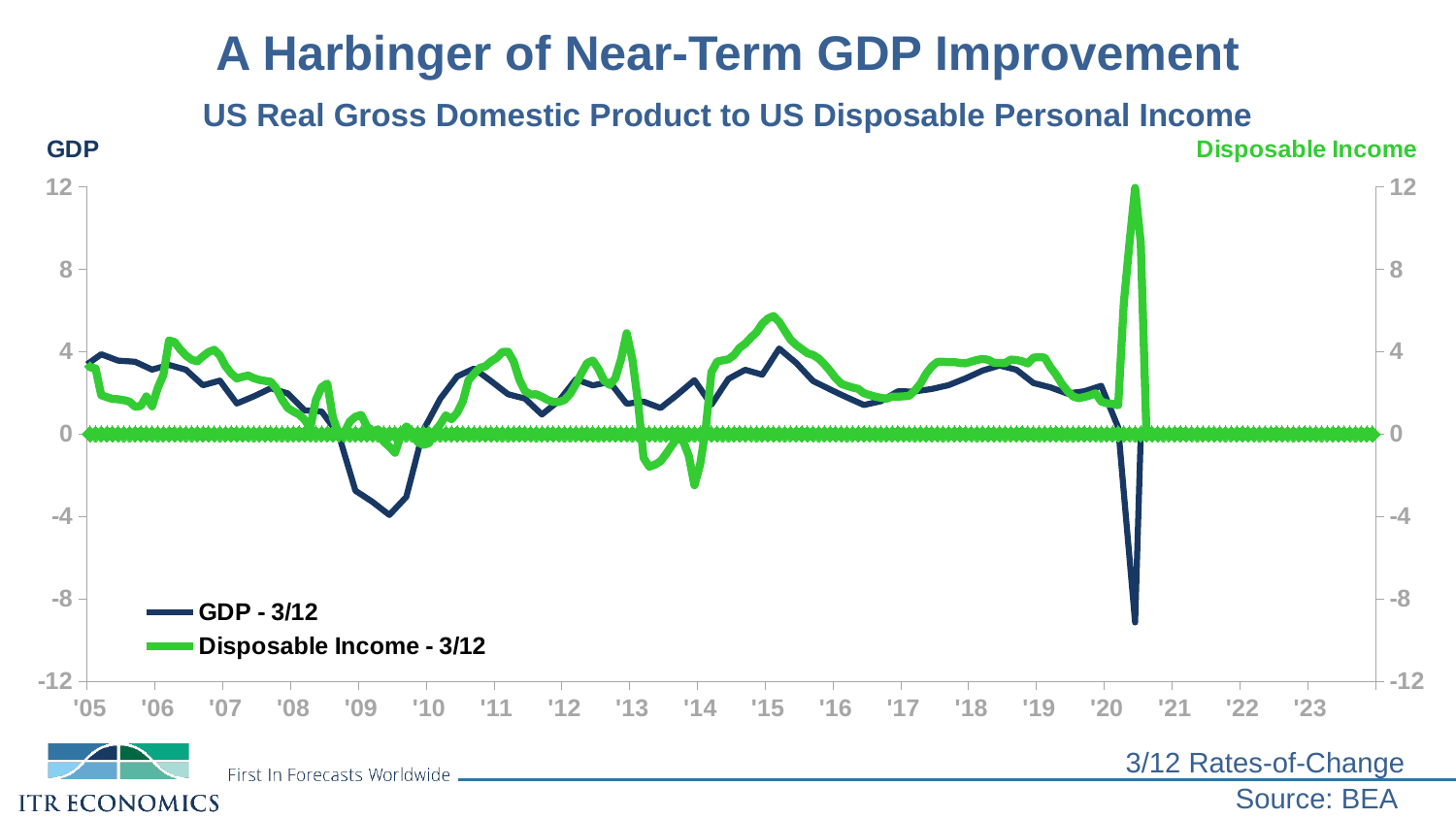
How many series does the legend list? 2 Is the lowest value of the GDP - 3/12 line around 2009 greater or less than 0? less Is the lowest value of the GDP - 3/12 line in 2020 greater or less than -8? less Does the GDP - 3/12 line rise or fall from '08 to '09? fall What kind of chart is shown on the slide? line chart Which series reaches the highest value anywhere on the chart? Disposable Income - 3/12 Is the lowest value of the Disposable Income - 3/12 line around 2014 greater or less than 0? less What are the two series named in the legend? GDP - 3/12 and Disposable Income - 3/12 Which series reaches the lowest value anywhere on the chart? GDP - 3/12 What is the subtitle of the chart below the main title? US Real Gross Domestic Product to US Disposable Personal Income How many year labels are shown on the x axis? 19